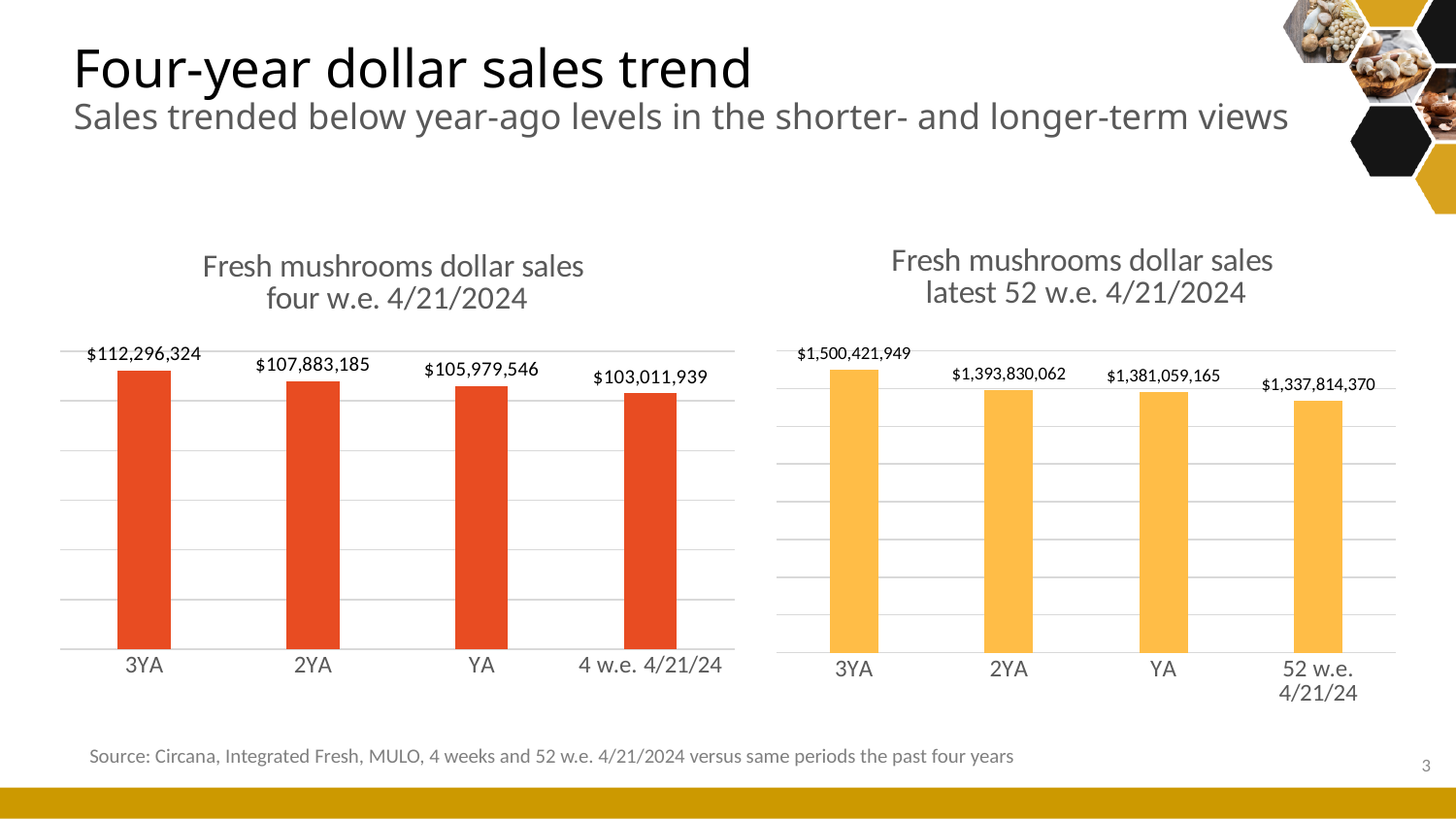
In the 'Fresh mushrooms dollar sales latest 52 w.e. 4/21/2024' chart, what is the value for 52 w.e. 4/21/24? $1,337,814,370 In the 'Fresh mushrooms dollar sales latest 52 w.e. 4/21/2024' chart, what is the value for YA? $1,381,059,165 In the 'Fresh mushrooms dollar sales latest 52 w.e. 4/21/2024' chart, do the values rise or fall from 3YA to 52 w.e. 4/21/24? Fall In the 'Fresh mushrooms dollar sales four w.e. 4/21/2024' chart, which is larger, the value for 2YA or the value for YA? 2YA In the 'Fresh mushrooms dollar sales four w.e. 4/21/2024' chart, what is the value for 3YA? $112,296,324 How many bars are in the 'Fresh mushrooms dollar sales latest 52 w.e. 4/21/2024' chart? 4 In the 'Fresh mushrooms dollar sales four w.e. 4/21/2024' chart, which period has the highest value? 3YA In the 'Fresh mushrooms dollar sales four w.e. 4/21/2024' chart, what is the value for 4 w.e. 4/21/24? $103,011,939 In the 'Fresh mushrooms dollar sales four w.e. 4/21/2024' chart, what is the difference between the 3YA value and the 4 w.e. 4/21/24 value? $9,284,385 In the 'Fresh mushrooms dollar sales latest 52 w.e. 4/21/2024' chart, which period has the lowest value? 52 w.e. 4/21/24 In the 'Fresh mushrooms dollar sales latest 52 w.e. 4/21/2024' chart, what is the difference between the 2YA value and the YA value? $12,770,897 What kind of chart is the 'Fresh mushrooms dollar sales four w.e. 4/21/2024' chart? Bar chart